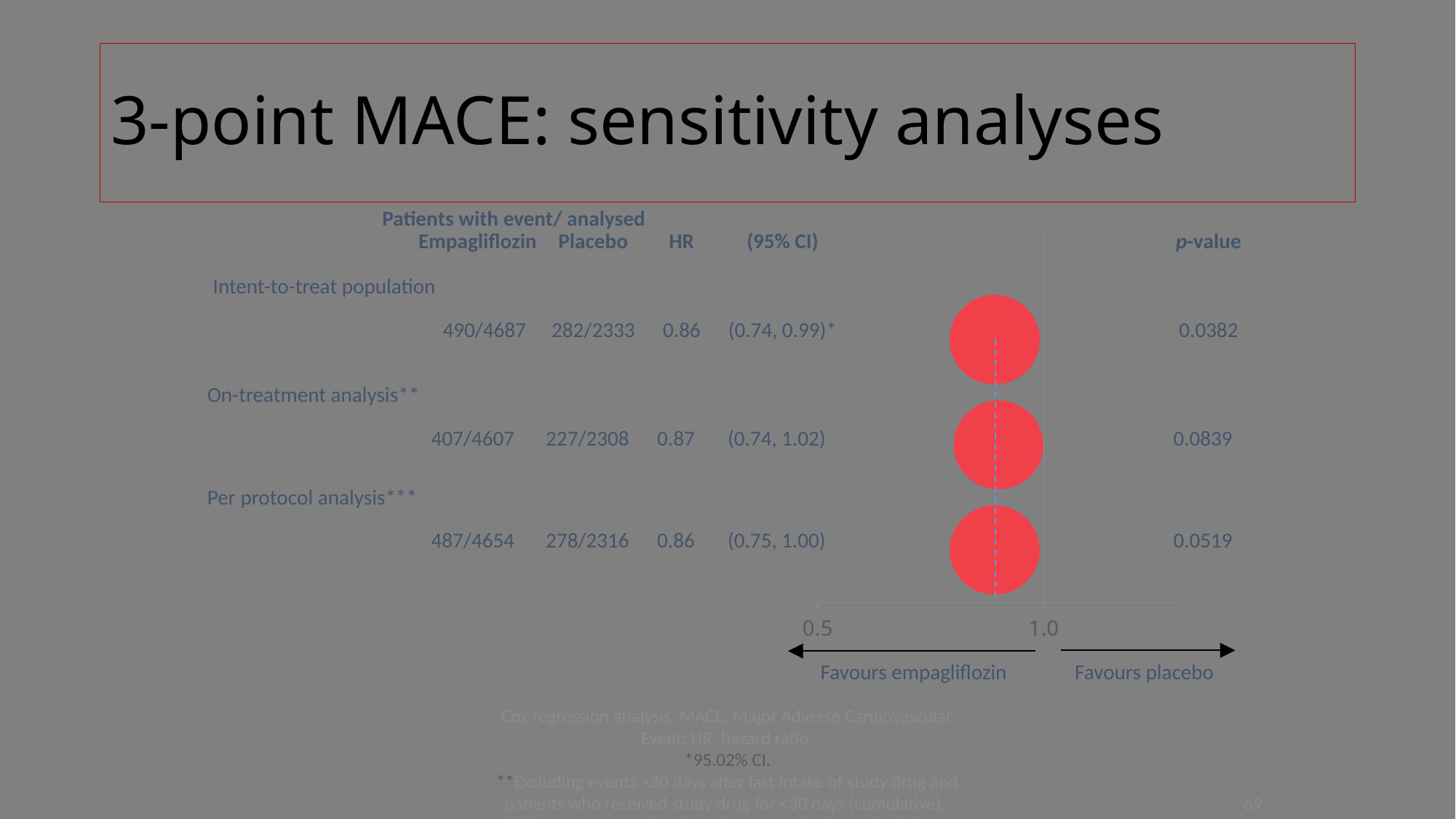
Which analysis has the highest hazard ratio? On-treatment analysis What is the 95% CI for the on-treatment analysis? (0.74, 1.02) What label appears under the left side of the axis, below the arrow pointing left? Favours empagliflozin What is the hazard ratio (HR) for the intent-to-treat population? 0.86 What is the hazard ratio (HR) for the on-treatment analysis? 0.87 How many analyses are plotted in the chart? 3 Is the hazard ratio for the per protocol analysis greater or less than 1.0? less Which analysis has the lowest p-value? Intent-to-treat population Which has the larger p-value, the on-treatment analysis or the per protocol analysis? On-treatment analysis What is the p-value for the per protocol analysis? 0.0519 What is the difference between the p-value of the on-treatment analysis and the p-value of the intent-to-treat population? 0.0457 What is the number of empagliflozin patients with event/analysed in the intent-to-treat population? 490/4687